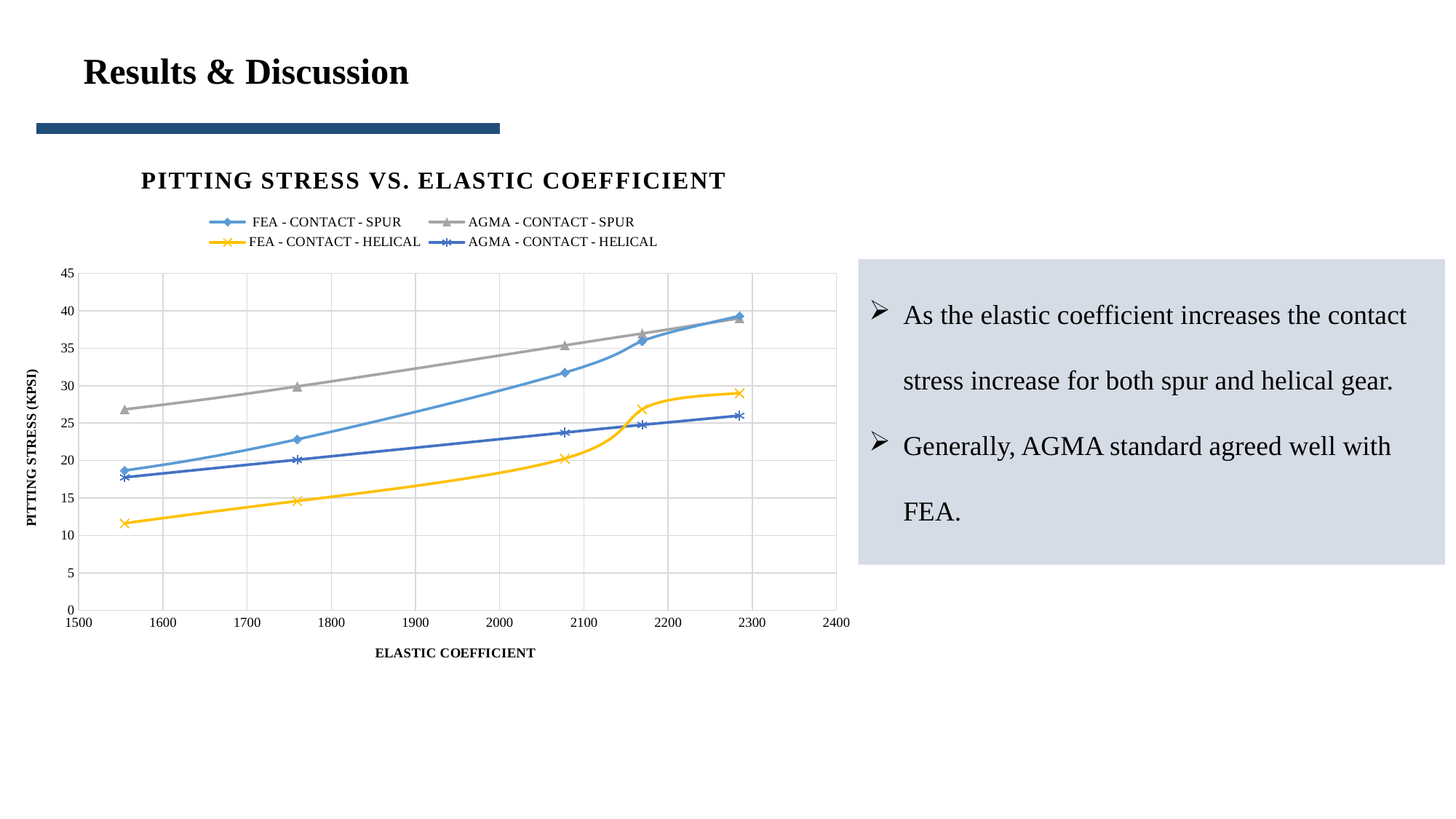
Is the value for FEA - CONTACT - HELICAL at the lowest elastic coefficient greater or less than 15? less Is the value for AGMA - CONTACT - SPUR at the lowest elastic coefficient greater or less than 20? greater Do the pitting stress values rise or fall as the elastic coefficient increases? rise Is the value for FEA - CONTACT - SPUR at the highest elastic coefficient greater or less than 35? greater What is the title of the chart? PITTING STRESS VS. ELASTIC COEFFICIENT What is the label of the y axis? PITTING STRESS (KPSI) How many series does the legend list? 4 Which series has the lowest pitting stress at the lowest elastic coefficient? FEA - CONTACT - HELICAL At the lowest elastic coefficient, which is higher: AGMA - CONTACT - SPUR or FEA - CONTACT - SPUR? AGMA - CONTACT - SPUR What kind of chart is shown on the slide? line chart How many data points are plotted for the FEA - CONTACT - SPUR series? 5